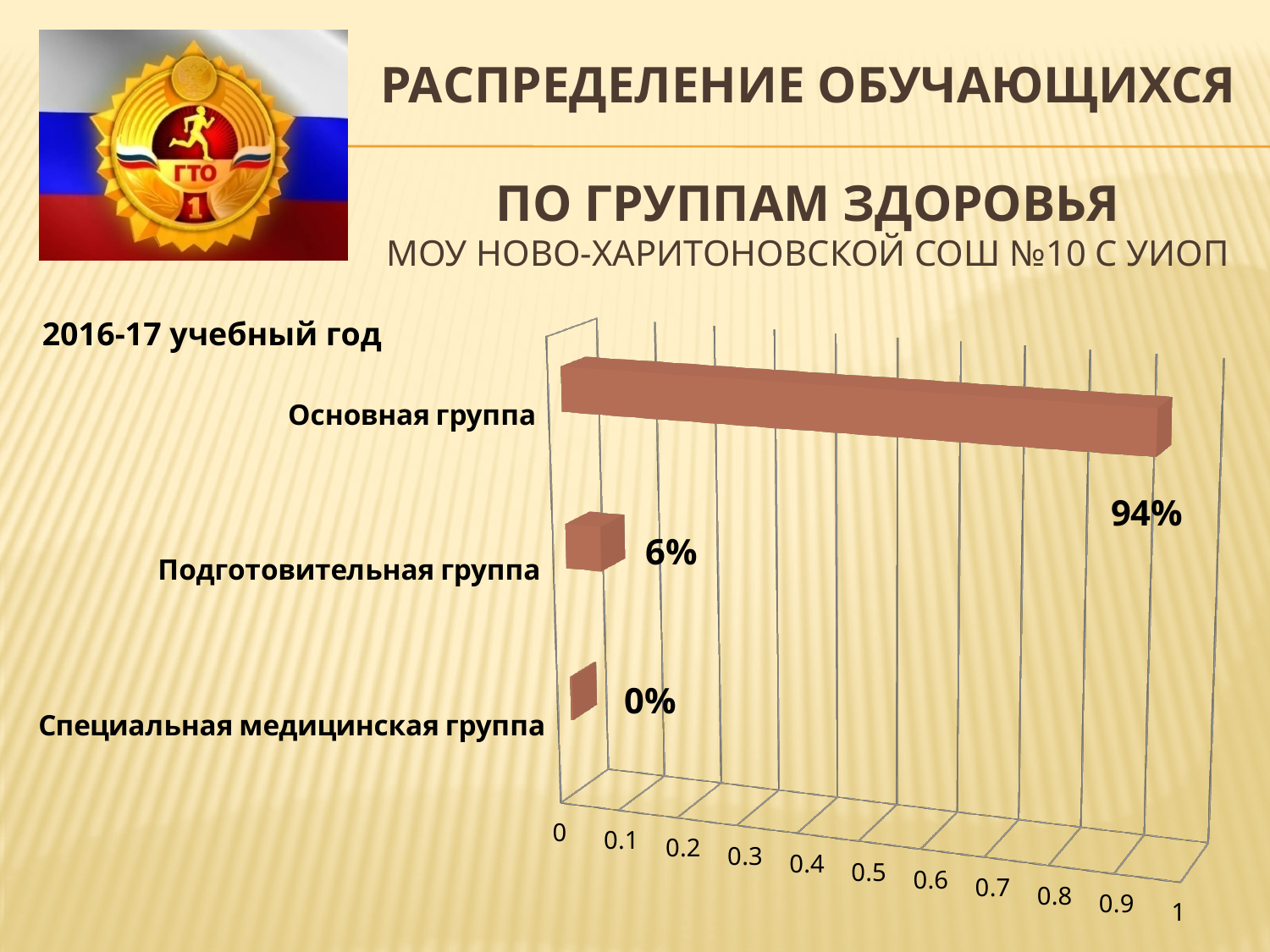
How many categories are shown in the chart? 3 Which is larger, the value for Подготовительная группа or the value for Специальная медицинская группа? Подготовительная группа What kind of chart is shown on the slide? bar chart What is the maximum value shown on the horizontal axis? 1 Which school year does the chart cover, according to the label above it? 2016-17 учебный год What is the value for Подготовительная группа? 6% Which category has the highest value? Основная группа What is the difference between the values for Основная группа and Подготовительная группа? 88% Which category has the lowest value? Специальная медицинская группа What is the value for Основная группа? 94% Is the value for Основная группа greater or less than 0.5? greater What is the value for Специальная медицинская группа? 0%